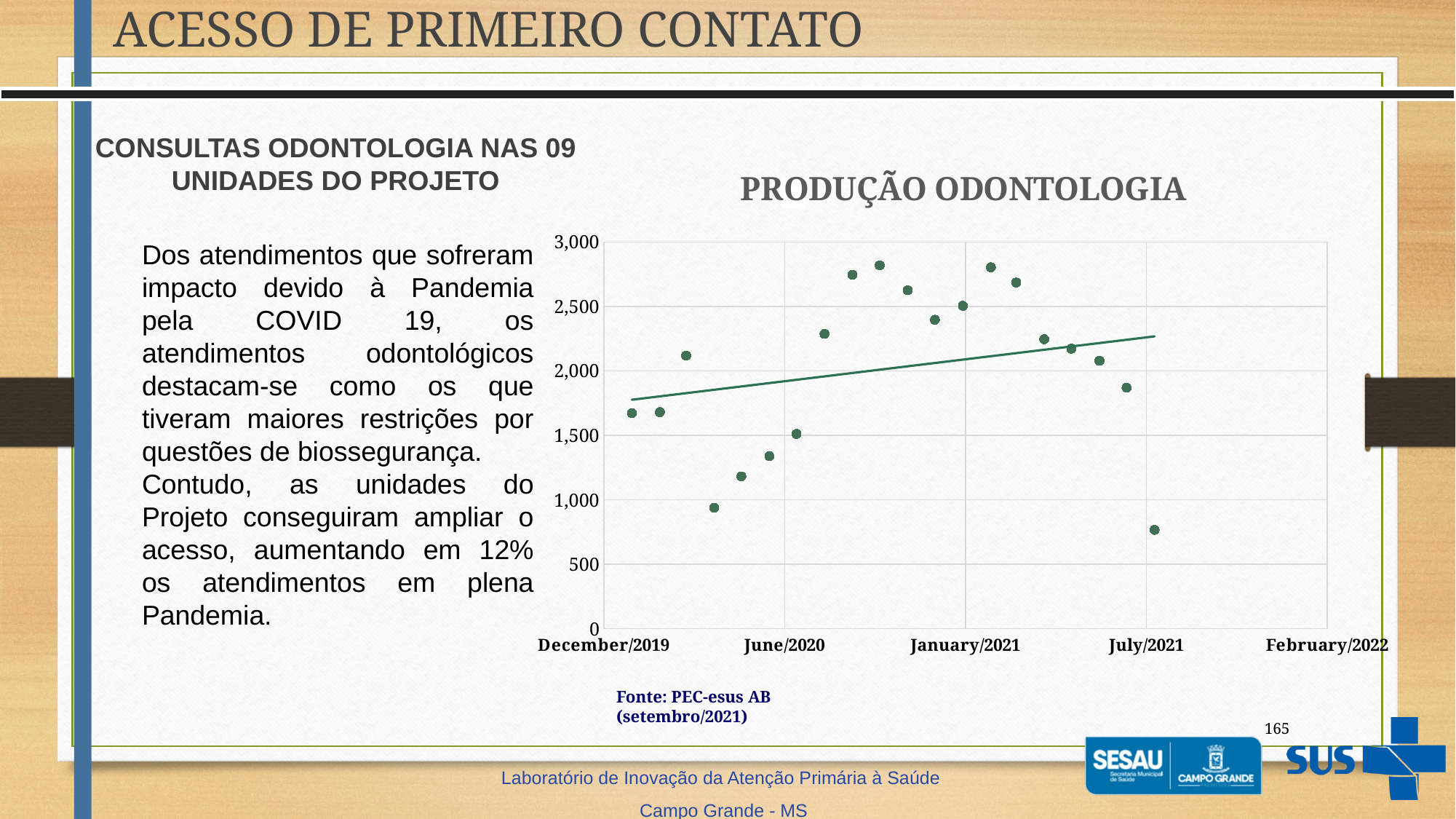
What kind of chart is shown under the title PRODUÇÃO ODONTOLOGIA? scatter chart What is the title of the chart on the slide? PRODUÇÃO ODONTOLOGIA Is the first (leftmost) point in the chart greater or less than 1,500? greater How many data points are plotted in the chart? 20 Is the first (leftmost) point in the chart greater or less than 2,000? less What source is cited below the chart? Fonte: PEC-esus AB (setembro/2021) Which is larger in the chart: the first (leftmost) point or the last (rightmost) point? the first (leftmost) point Is the highest point in the chart greater or less than 2,500? greater Does the trend line in the chart rise or fall from left to right? rises How many date labels are shown on the x axis of the chart? 5